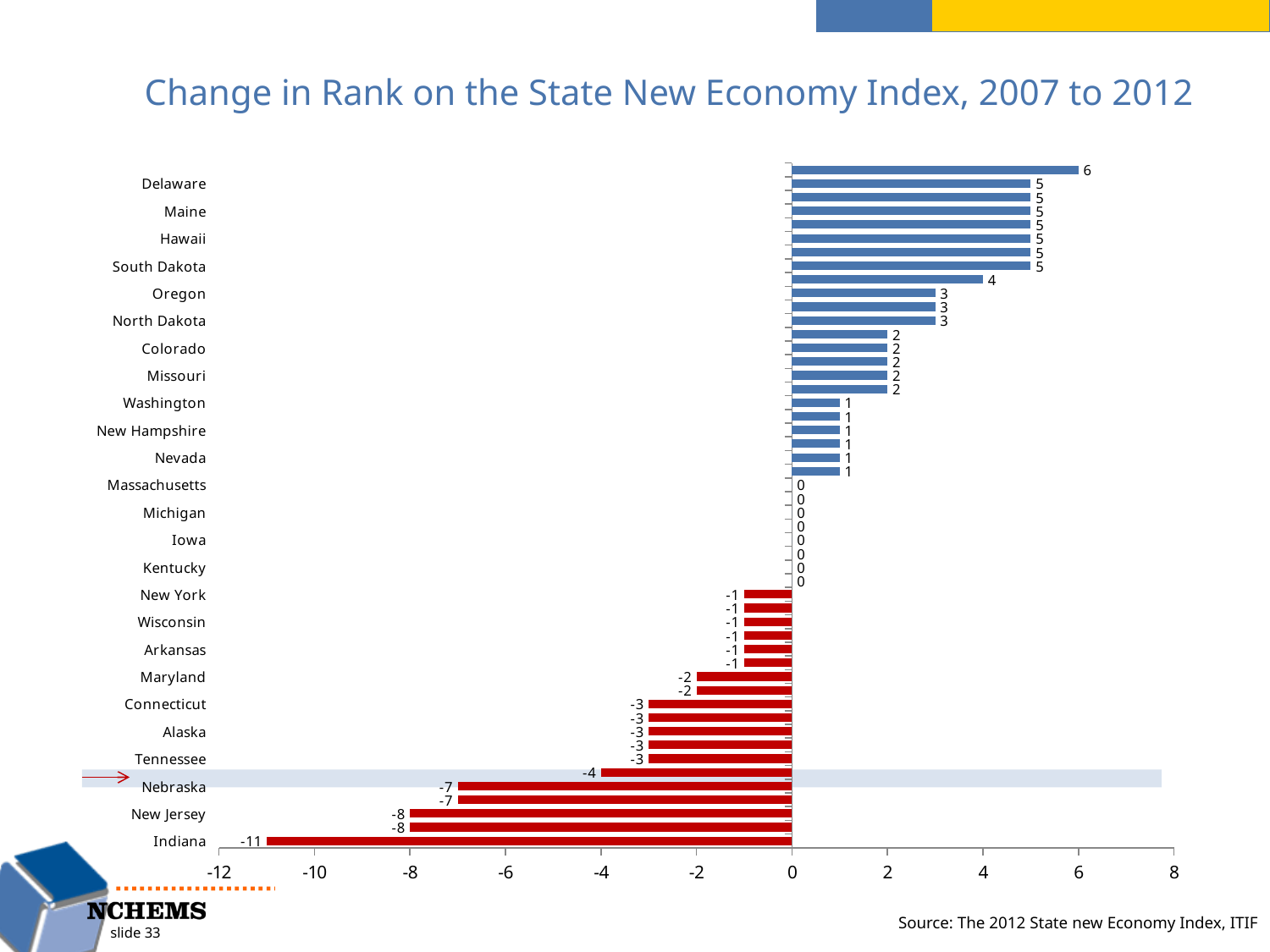
What is the change in rank for Delaware? 5 What is the change in rank for New Jersey? -8 What is the change in rank for Indiana? -11 What kind of chart is shown on the slide? Bar chart What is the change in rank for Nebraska? -7 What is the difference between the change in rank for Delaware and for Indiana? 16 Which has a larger change in rank, Oregon or Colorado? Oregon Which labeled state has the lowest change in rank? Indiana Which state's row is highlighted with an arrow on the chart? Nebraska What is the change in rank for Oregon? 3 Is the value for Nebraska greater or less than -4? less What is the change in rank for Massachusetts? 0